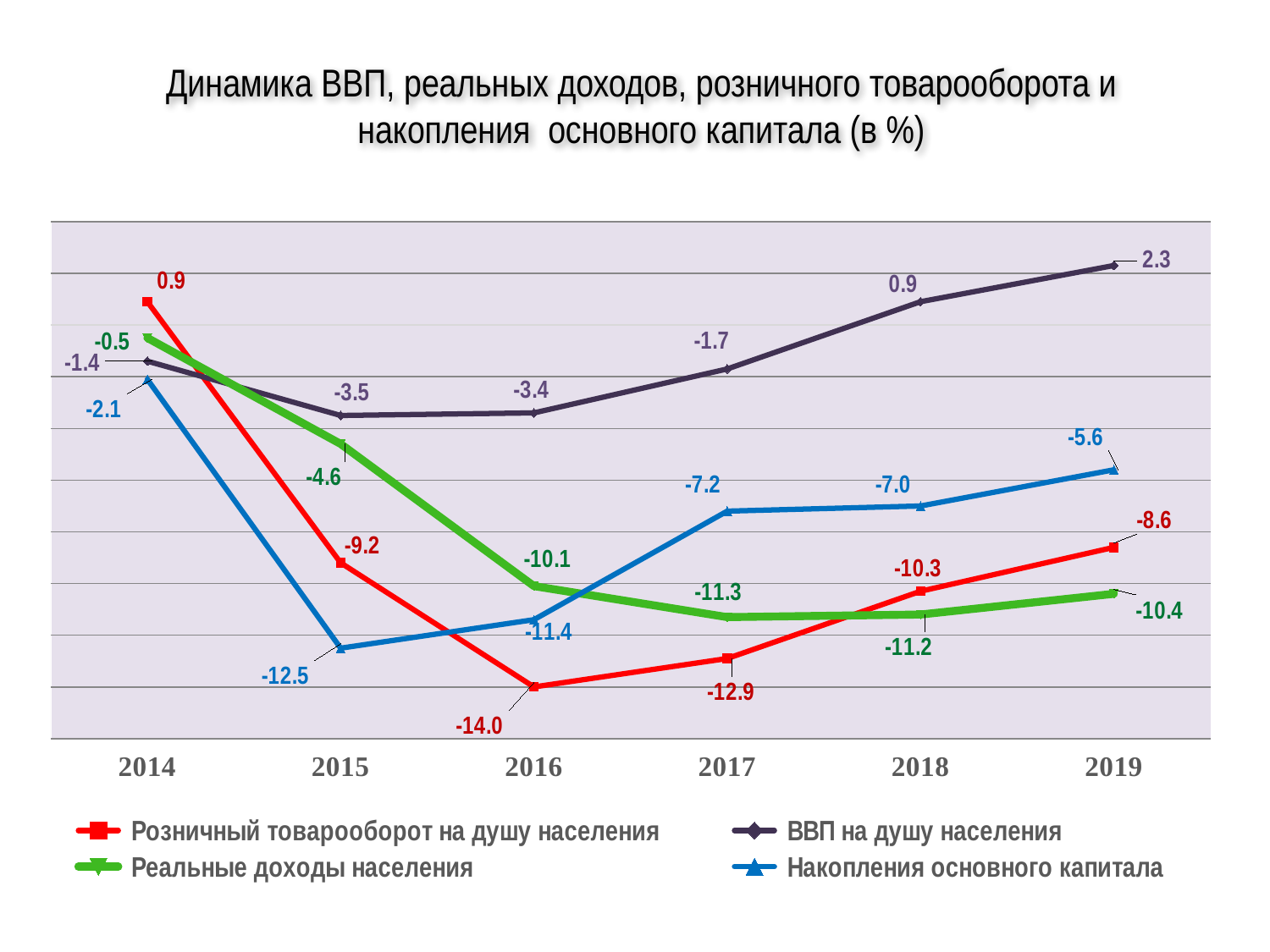
In which year does Розничный товарооборот на душу населения reach its lowest value? 2016 How many years are plotted along the x axis? 6 How many series does the legend list? 4 Which series has the higher value in 2018: Реальные доходы населения or Накопления основного капитала? Накопления основного капитала What is the value of Розничный товарооборот на душу населения in 2016? -14.0 What type of chart is shown on the slide? line chart What is the difference between the 2019 and 2014 values of ВВП на душу населения? 3.7 In which year does ВВП на душу населения reach its highest value? 2019 What is the value of ВВП на душу населения in 2019? 2.3 What is the value of Накопления основного капитала in 2015? -12.5 What is the value of Реальные доходы населения in 2017? -11.3 Does Розничный товарооборот на душу населения rise or fall from 2016 to 2019? rise